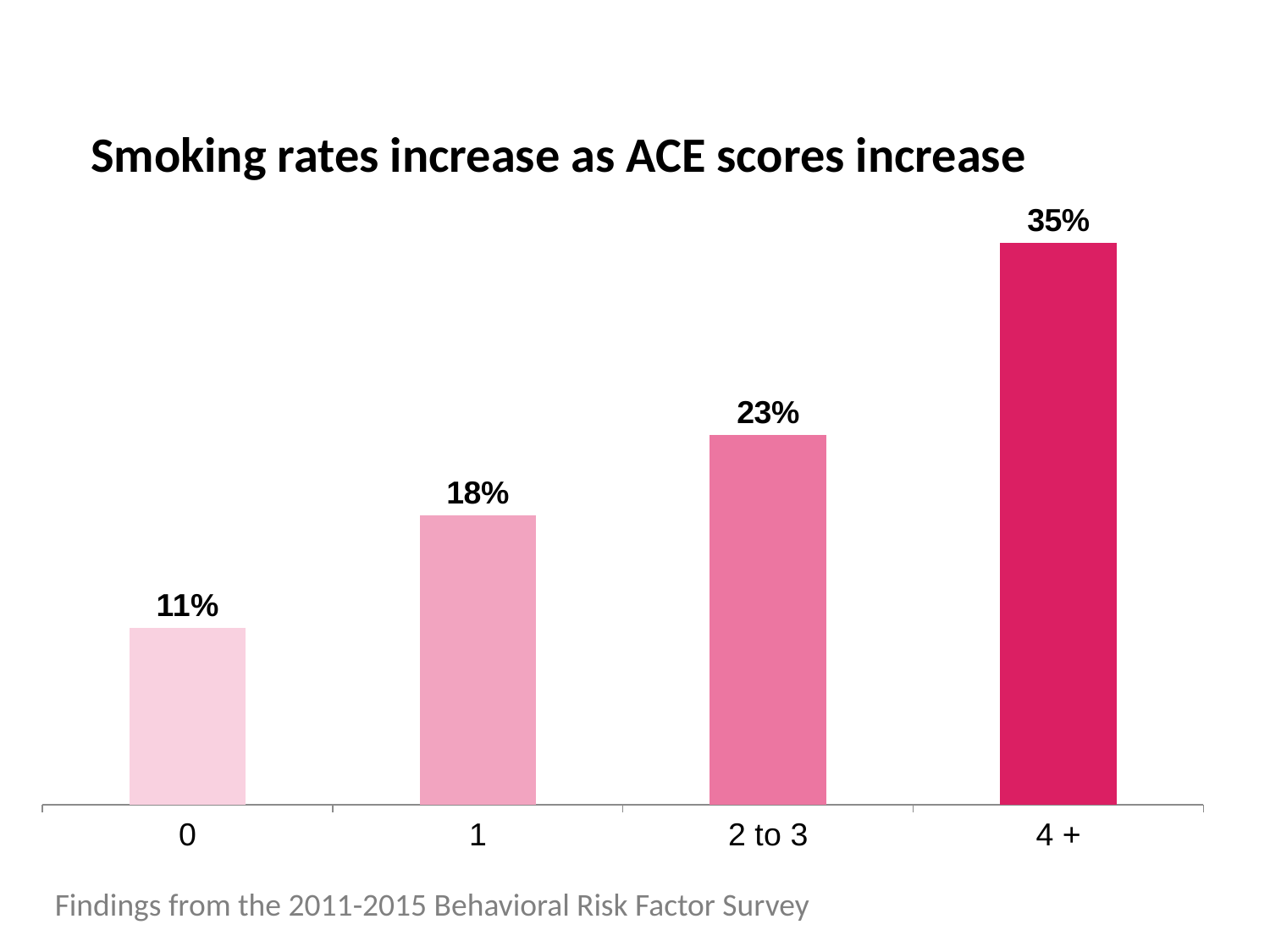
How many ACE score categories are shown in the chart? 4 What is the smoking rate for an ACE score of 4 +? 35% What is the smoking rate for an ACE score of 1? 18% Which has a higher smoking rate, ACE score 1 or ACE score 2 to 3? 2 to 3 What is the smoking rate for an ACE score of 0? 11% Which ACE score category has the lowest smoking rate? 0 What is the smoking rate for an ACE score of 2 to 3? 23% Do smoking rates rise or fall as ACE scores increase along the x axis? Rise What is the difference in smoking rate between the 4 + and 0 ACE score categories? 24% What is the difference in smoking rate between the 2 to 3 and 1 ACE score categories? 5% What kind of chart is shown on the slide? Bar chart Which ACE score category has the highest smoking rate? 4 +